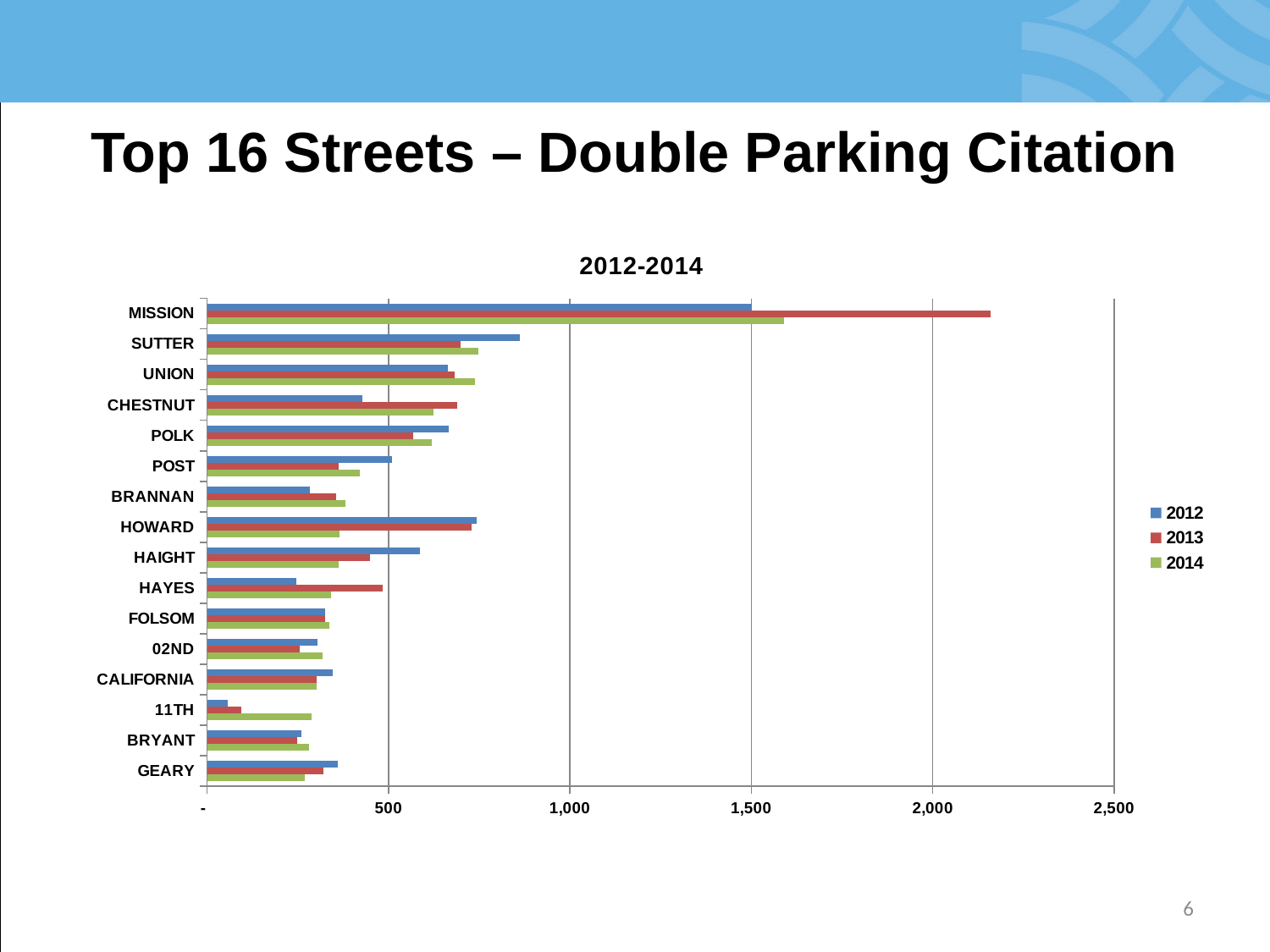
For MISSION, which is larger: the 2013 value or the 2014 value? 2013 How many series does the legend list? 3 Which street has the lowest value for 2012? 11TH What is the title shown above the chart? 2012-2014 Is the 2013 value for MISSION greater or less than 2,000? greater For HOWARD, which is larger: the 2012 value or the 2014 value? 2012 Is the 2012 value for SUTTER greater or less than 500? greater Is the 2012 value for HAYES greater or less than 500? less What kind of chart is shown on the slide? Bar chart How many streets are shown on the chart? 16 Which street has the highest value for 2013? MISSION